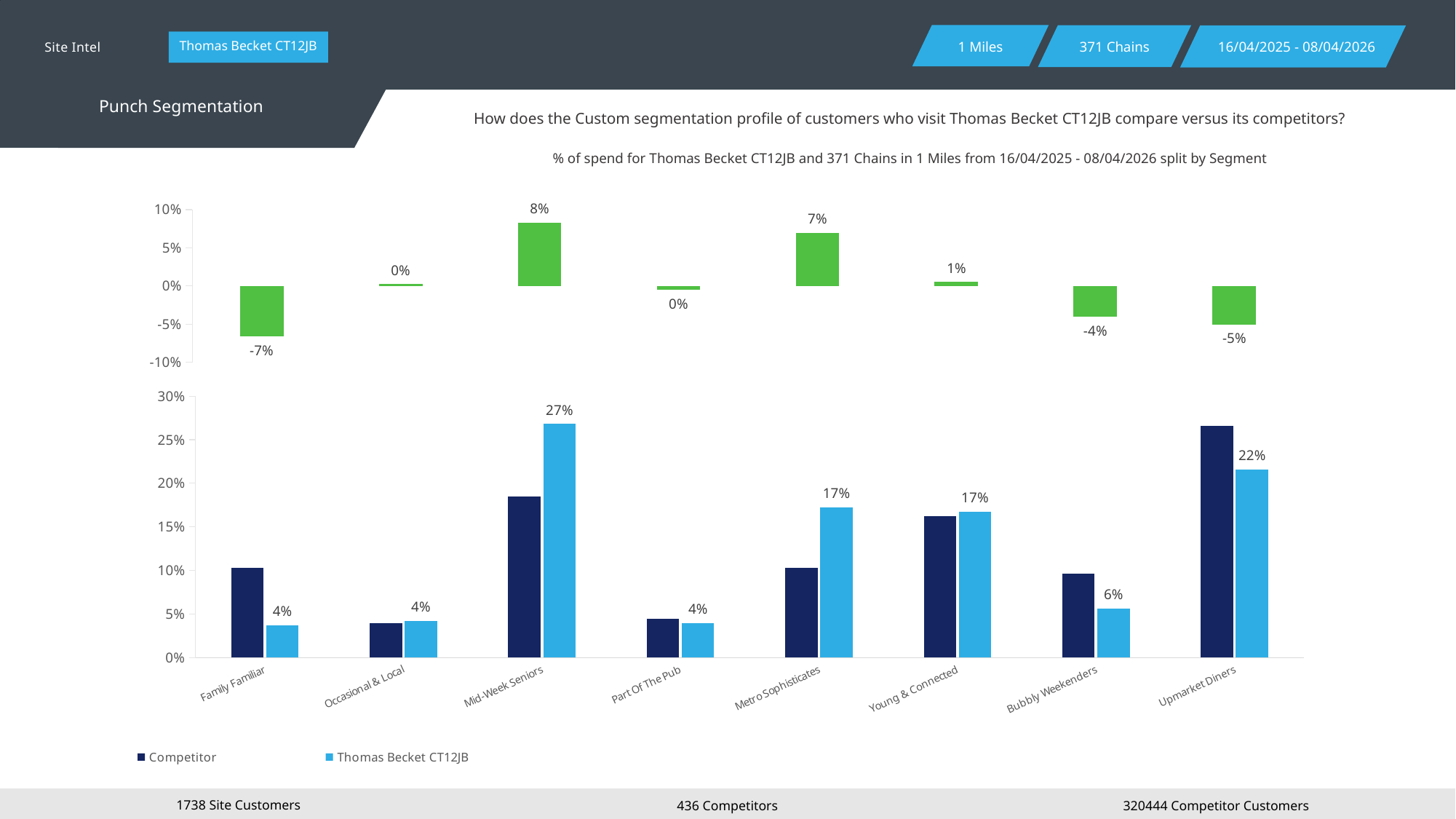
In the top chart, what is the value for Mid-Week Seniors? 8% In the top chart, which segment has the lowest value? Family Familiar In the bottom chart, which segment has the highest Thomas Becket CT12JB value? Mid-Week Seniors In the top chart, what is the difference between the values for Mid-Week Seniors and Metro Sophisticates? 1% How many segments are shown on the x axis of the bottom chart? 8 In the top chart, what is the value for Family Familiar? -7% How many series does the legend of the bottom chart list? 2 In the bottom chart, is the Competitor value for Upmarket Diners greater or less than 25%? greater In the bottom chart, what is the Thomas Becket CT12JB value for Upmarket Diners? 22% In the top chart, which segment has the highest value? Mid-Week Seniors In the bottom chart, which is larger for Family Familiar: the Competitor value or the Thomas Becket CT12JB value? Competitor In the bottom chart, what is the Thomas Becket CT12JB value for Bubbly Weekenders? 6%